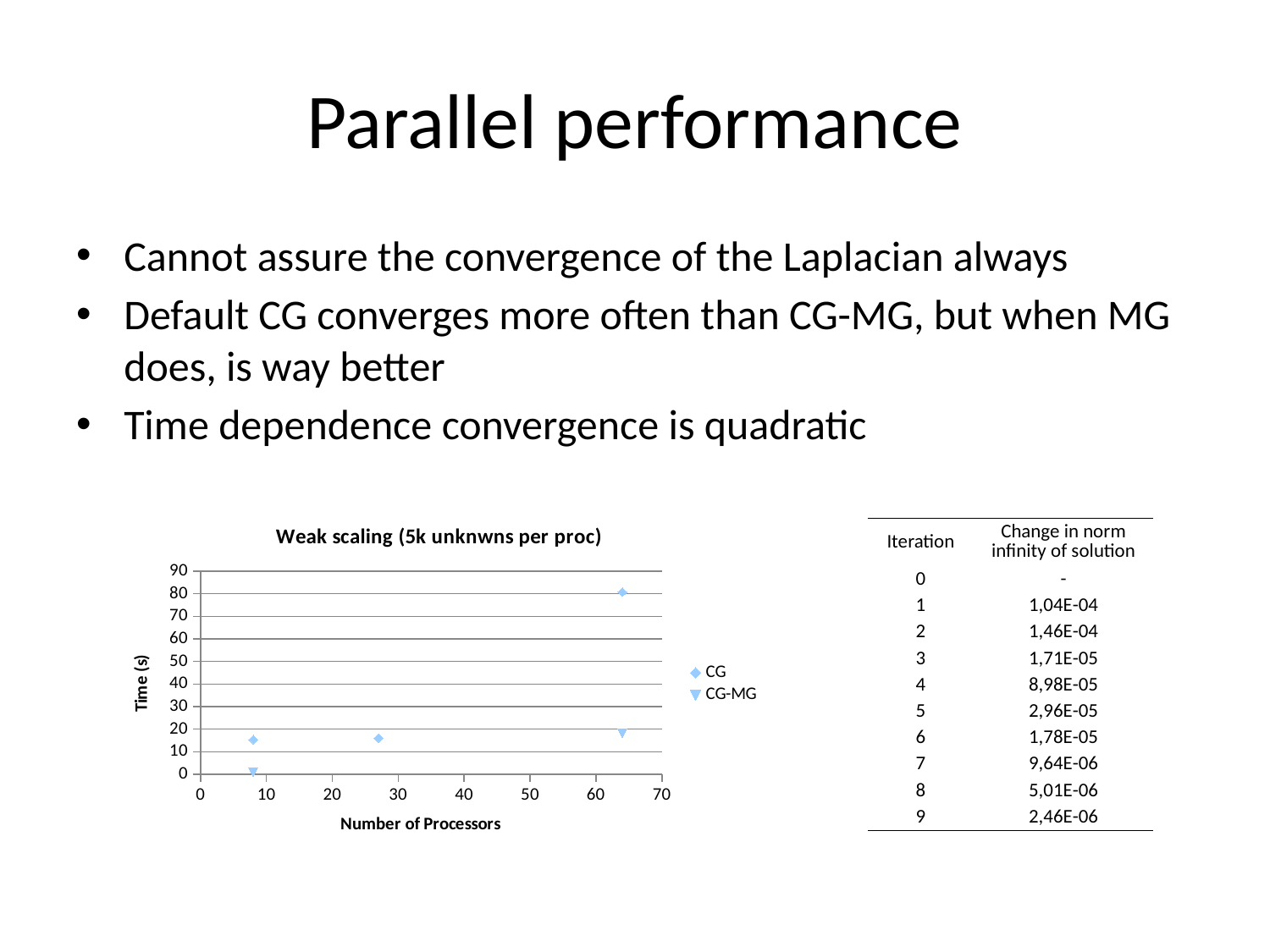
How many CG points are plotted on the chart? 3 Which series contains the point with the highest time on the chart? CG At the highest number of processors plotted, which series has the larger time, CG or CG-MG? CG What are the two series named in the chart legend? CG and CG-MG Is the time for the rightmost CG point greater or less than 70 seconds? greater Is the time for the rightmost CG-MG point greater or less than 30 seconds? less Is the time for the leftmost CG-MG point greater or less than 10 seconds? less What kind of chart is shown on the slide? scatter chart How many series does the chart legend list? 2 What is the title of the chart? Weak scaling (5k unknwns per proc) Does the CG time rise or fall as the number of processors increases? rise